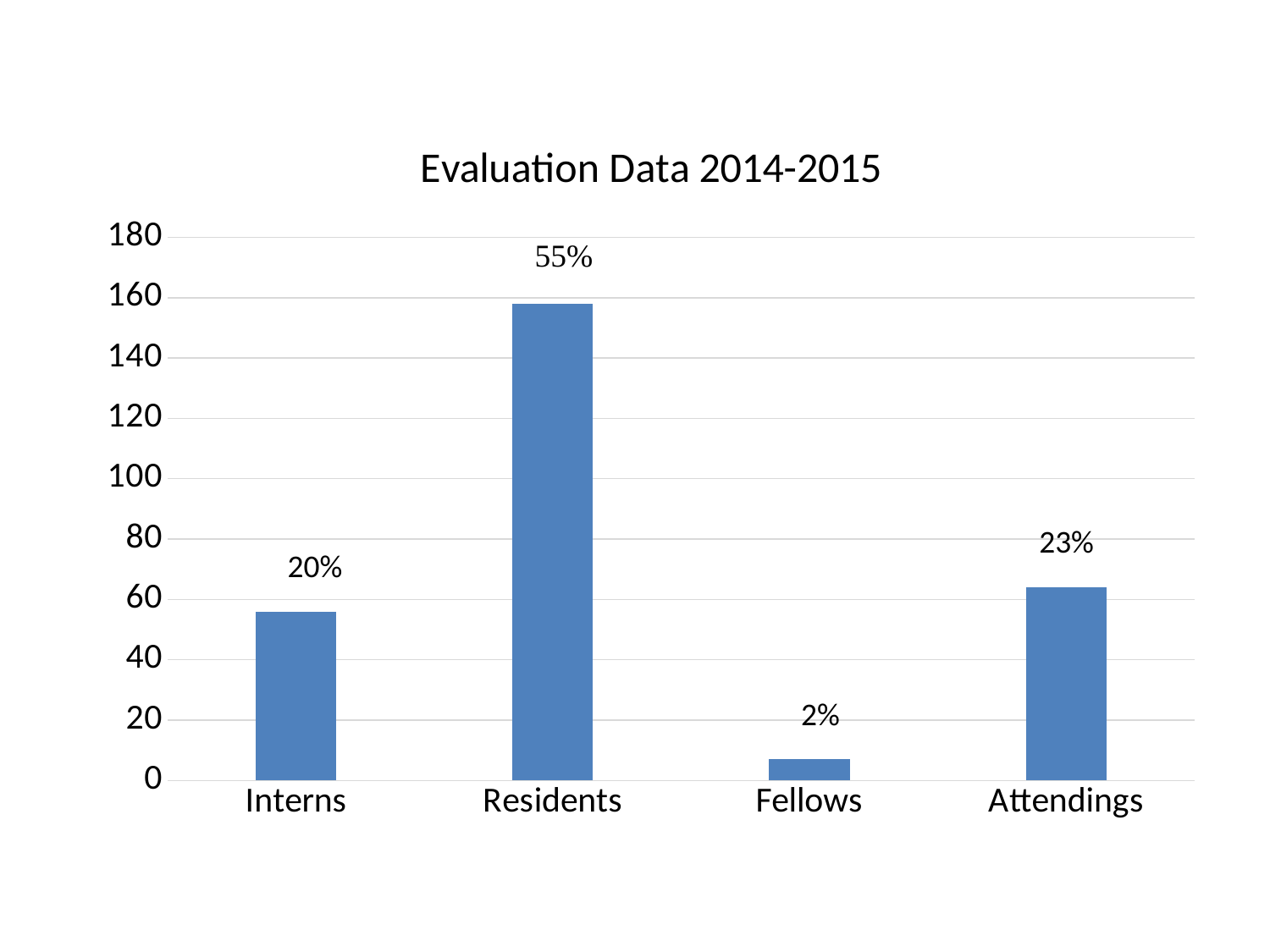
What percentage label is shown above the Interns bar? 20% Which category has the lowest bar? Fellows What percentage label is shown above the Residents bar? 55% What percentage label is shown above the Fellows bar? 2% What type of chart is shown on the slide? bar chart Is the value for Interns greater or less than 60? less What is the title of the chart? Evaluation Data 2014-2015 How many categories are shown on the x axis of the chart? 4 Which bar is taller, Interns or Attendings? Attendings Which category has the highest bar? Residents What percentage label is shown above the Attendings bar? 23% Is the value for Residents greater or less than 140? greater